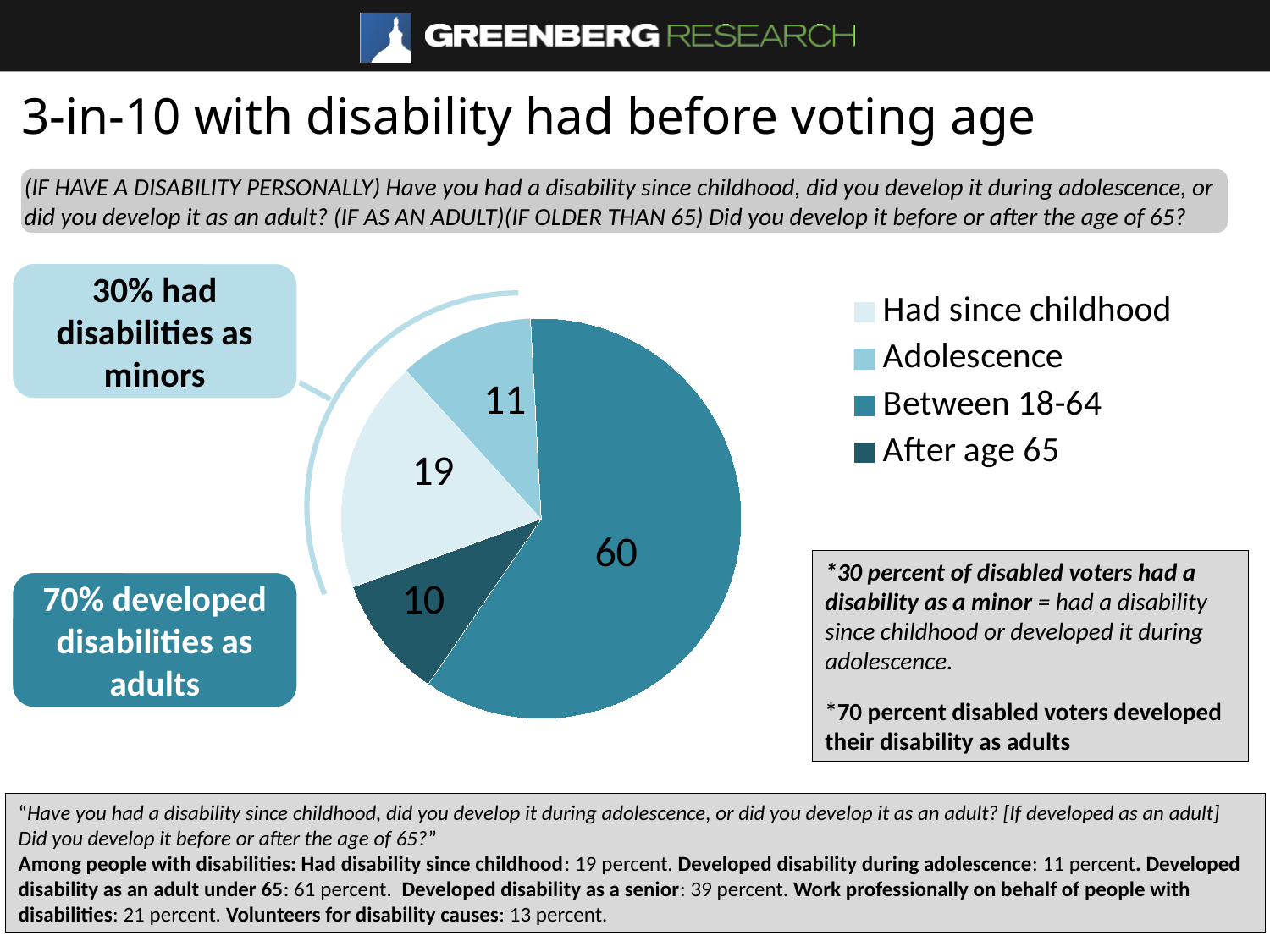
Which category has the largest slice in the pie chart? Between 18-64 What is the value for the 'Had since childhood' slice of the pie chart? 19 How many entries does the legend of the pie chart list? 4 What is the value for the 'Between 18-64' slice of the pie chart? 60 What is the difference between the 'Had since childhood' value and the 'Adolescence' value in the pie chart? 8 What share of the pie chart does the 'Between 18-64' slice represent? 60% What type of chart is shown on the slide? pie chart What is the difference between the 'Between 18-64' value and the 'Had since childhood' value in the pie chart? 41 Which is larger in the pie chart, 'Had since childhood' or 'Adolescence'? Had since childhood What is the value for the 'After age 65' slice of the pie chart? 10 What is the value for the 'Adolescence' slice of the pie chart? 11 How many slices does the pie chart have? 4